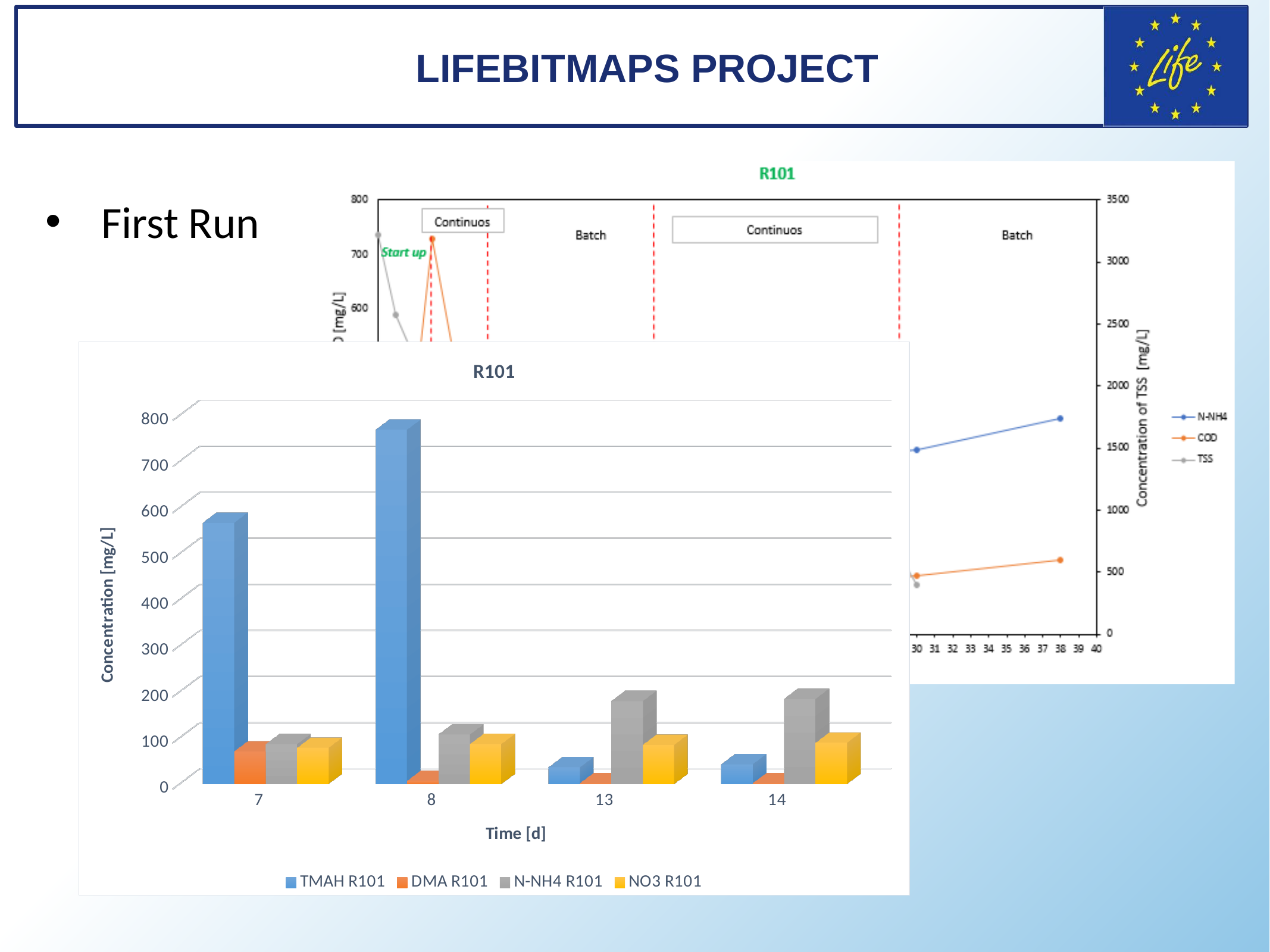
In the bar chart in the front of the slide, is the TMAH R101 value at day 13 greater or less than 100? less In the bar chart in the front of the slide, how many time categories are shown on the x axis? 4 In the bar chart in the front of the slide, is the N-NH4 R101 value at day 13 greater or less than 100? greater In the bar chart in the front of the slide, how many series does the legend list? 4 What kind of chart is the chart in the front of the slide (the one with the legend TMAH R101, DMA R101, N-NH4 R101, NO3 R101)? bar chart In the bar chart in the front of the slide, do the N-NH4 R101 values rise or fall from day 7 to day 14? rise In the line chart in the background of the slide, how many series does the legend list? 3 In the bar chart in the front of the slide, is the TMAH R101 value at day 7 greater or less than 500? greater In the bar chart in the front of the slide, which is larger: the TMAH R101 value at day 7 or at day 8? day 8 In the bar chart in the front of the slide, which series has the highest value at day 13? N-NH4 R101 In the bar chart in the front of the slide, at which time [d] is the TMAH R101 value highest? 8